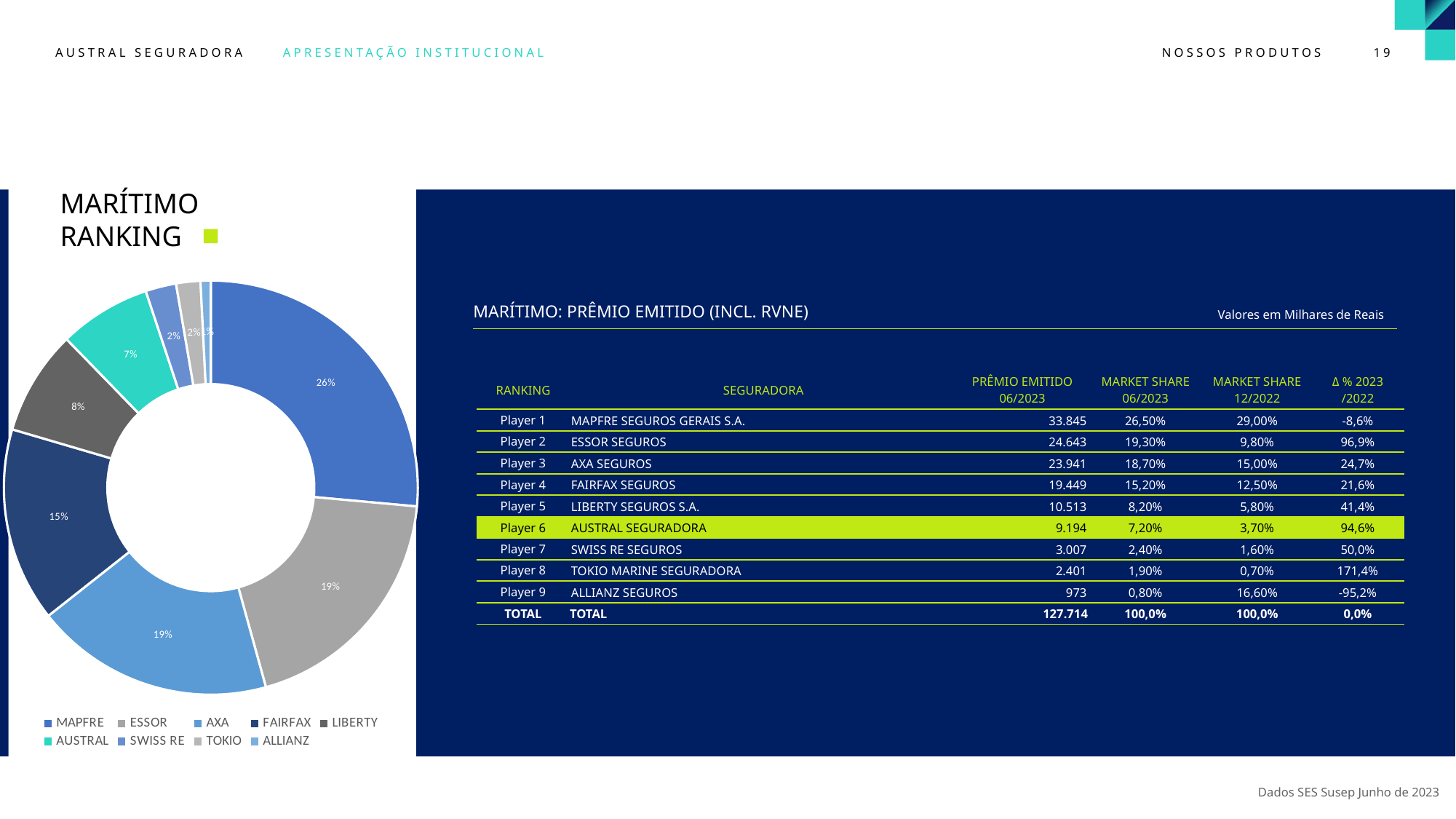
In the MARÍTIMO RANKING pie chart, what share does LIBERTY have? 8% What is the title of the pie chart on the slide? MARÍTIMO RANKING In the MARÍTIMO RANKING pie chart, what is the difference in percentage points between FAIRFAX's share and LIBERTY's share? 7% What kind of chart is shown on the left of the slide? doughnut chart In the MARÍTIMO RANKING pie chart, which is larger, the slice for LIBERTY or the slice for AUSTRAL? LIBERTY In the MARÍTIMO RANKING pie chart, what share does MAPFRE have? 26% In the MARÍTIMO RANKING pie chart, what share does AUSTRAL have? 7% In the MARÍTIMO RANKING pie chart, what share does FAIRFAX have? 15% How many companies are shown in the MARÍTIMO RANKING pie chart? 9 Which company has the smallest slice in the MARÍTIMO RANKING pie chart? ALLIANZ In the MARÍTIMO RANKING pie chart, what is the difference in percentage points between MAPFRE's share and FAIRFAX's share? 11% Which company has the largest slice in the MARÍTIMO RANKING pie chart? MAPFRE